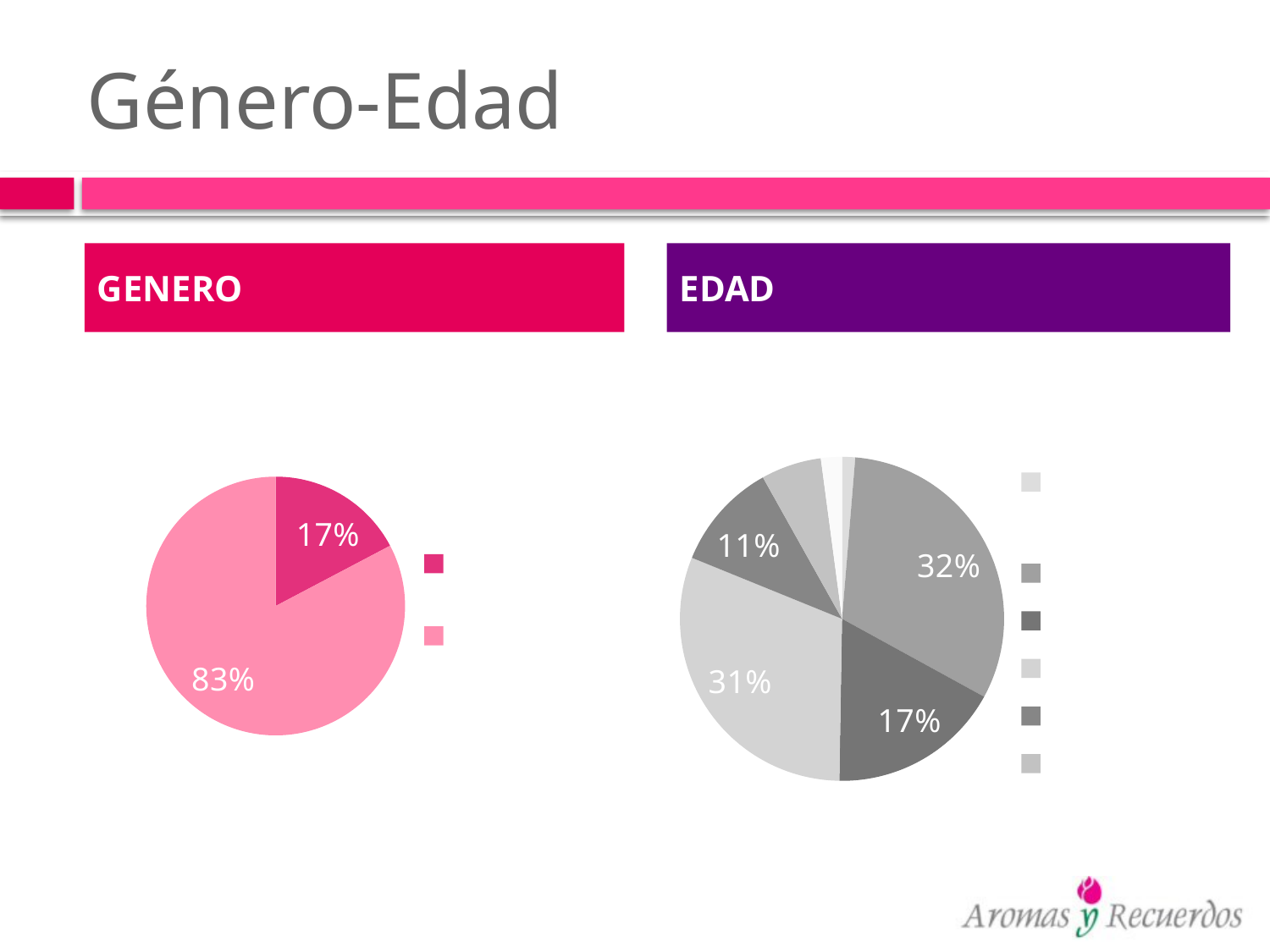
In the EDAD pie chart, what is the value of the largest labelled slice? 32% In the GENERO pie chart, what is the value of the smallest slice? 17% What type of chart is the EDAD chart on the right? pie chart In the EDAD pie chart, what is the difference between the 32% slice and the 11% slice? 21 percentage points How many slices does the EDAD pie chart have? 7 In the GENERO pie chart, what colour is the 83% slice? light pink How many slices does the GENERO pie chart have? 2 In the GENERO pie chart, what is the difference between the two slices (83% and 17%)? 66 percentage points What type of chart is the GENERO chart on the left? pie chart In the EDAD pie chart, which is larger: the slice labelled 32% or the slice labelled 17%? 32% In the GENERO pie chart, what is the value of the largest slice? 83%